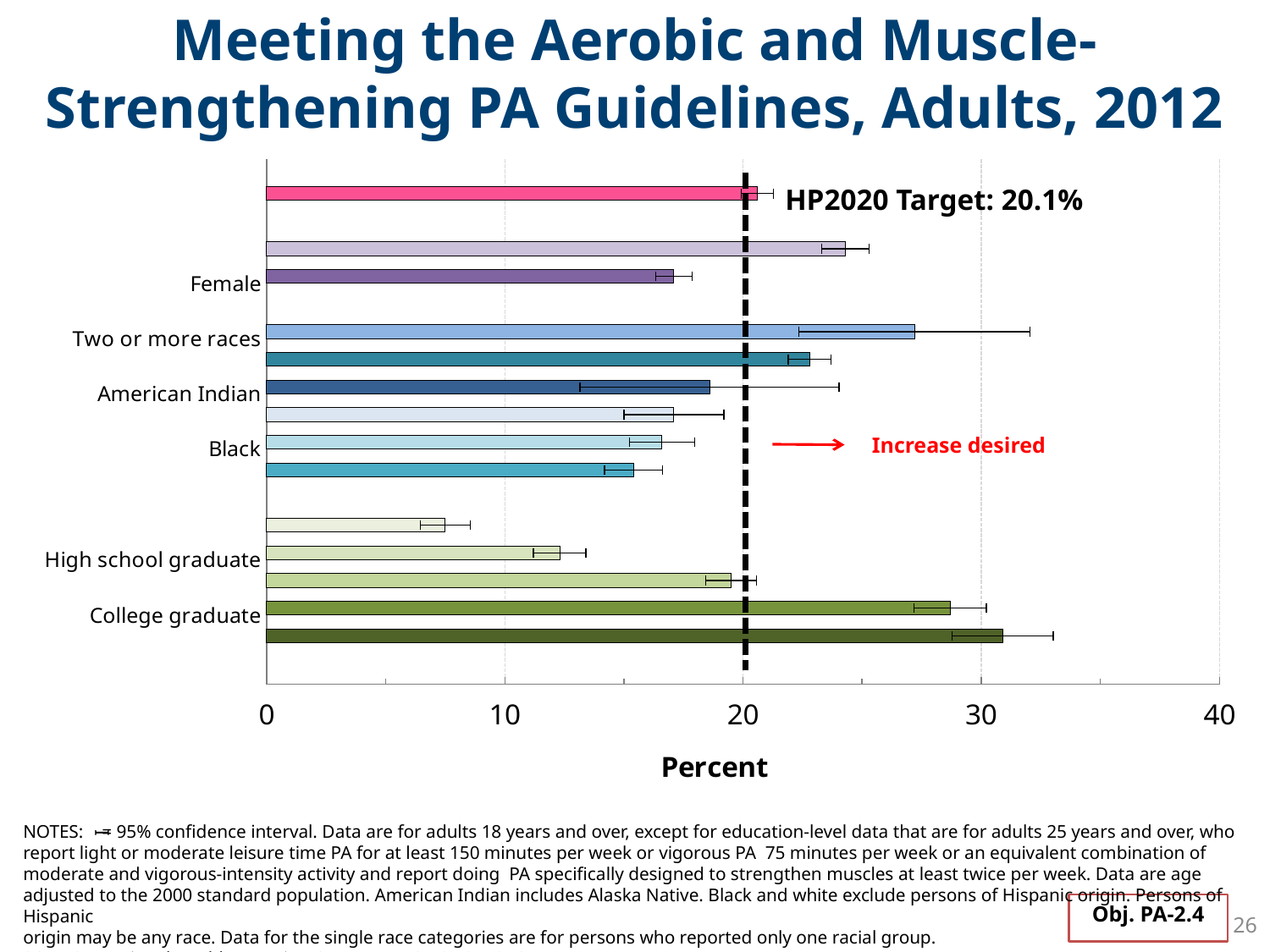
What is the HP2020 Target value shown on the chart? 20.1% Which has the larger value, Two or more races or Female? Two or more races Is the value for Female greater or less than 20? less Is the value for High school graduate greater or less than 20? less Is the value for Black greater or less than 20? less Which has the larger value, College graduate or High school graduate? College graduate What is the highest value shown on the horizontal axis? 40 What kind of chart is shown on the slide? bar chart What is the title of the horizontal axis? Percent